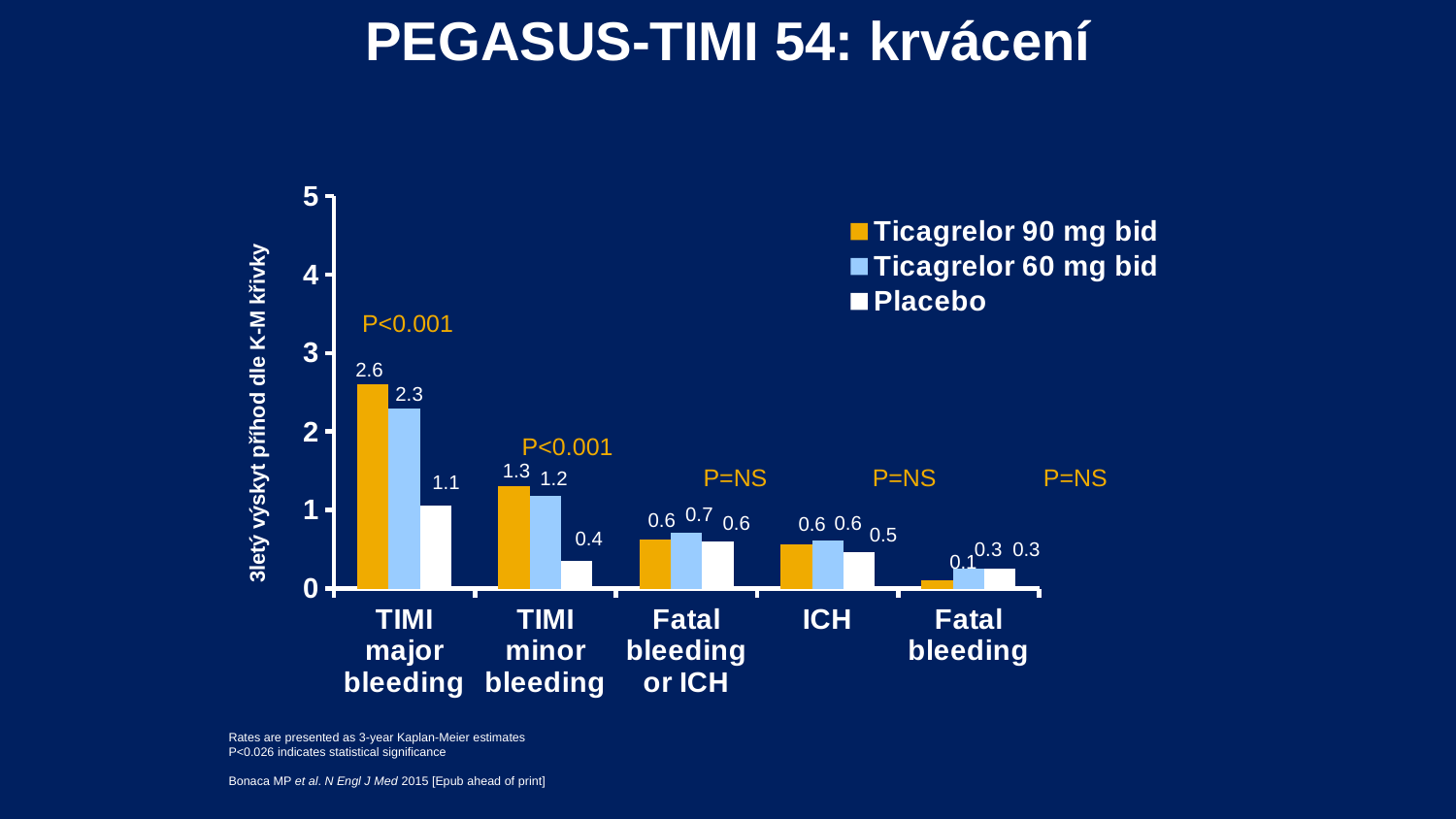
Which category has the lowest value for Ticagrelor 90 mg bid? Fatal bleeding What is the title of the slide? PEGASUS-TIMI 54: krvácení What is the value for Ticagrelor 60 mg bid in the Fatal bleeding or ICH category? 0.7 What kind of chart is shown on the slide? Bar chart How many series does the legend list? 3 What is the difference between the Ticagrelor 90 mg bid and Placebo values in the TIMI major bleeding category? 1.5 In the TIMI minor bleeding category, which is larger: Ticagrelor 90 mg bid or Placebo? Ticagrelor 90 mg bid What is the value for Ticagrelor 90 mg bid in the TIMI major bleeding category? 2.6 How many bleeding categories are shown on the x axis? 5 What is the value for Placebo in the ICH category? 0.5 Which category has the highest value for Ticagrelor 90 mg bid? TIMI major bleeding What is the value for Placebo in the TIMI minor bleeding category? 0.4